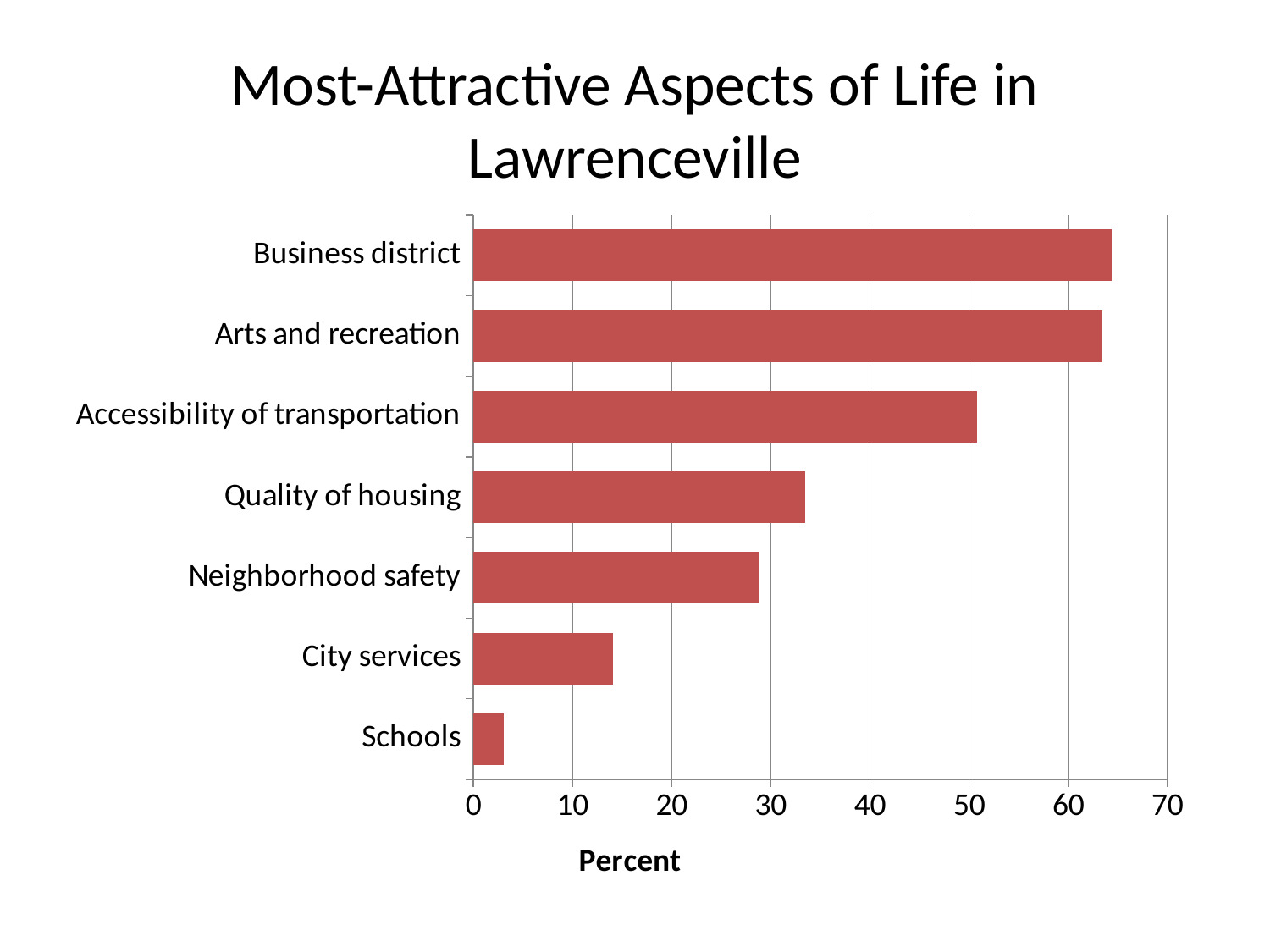
Which is larger, the value for Quality of housing or the value for City services? Quality of housing Is the value for Accessibility of transportation greater or less than 40? greater Is the value for Business district greater or less than 60? greater Is the value for City services greater or less than 10? greater Which category has the lowest value? Schools What is the label on the horizontal axis of the chart? Percent Which is larger, the value for Accessibility of transportation or the value for Neighborhood safety? Accessibility of transportation What kind of chart is shown on the slide? bar chart How many categories are plotted in the chart? 7